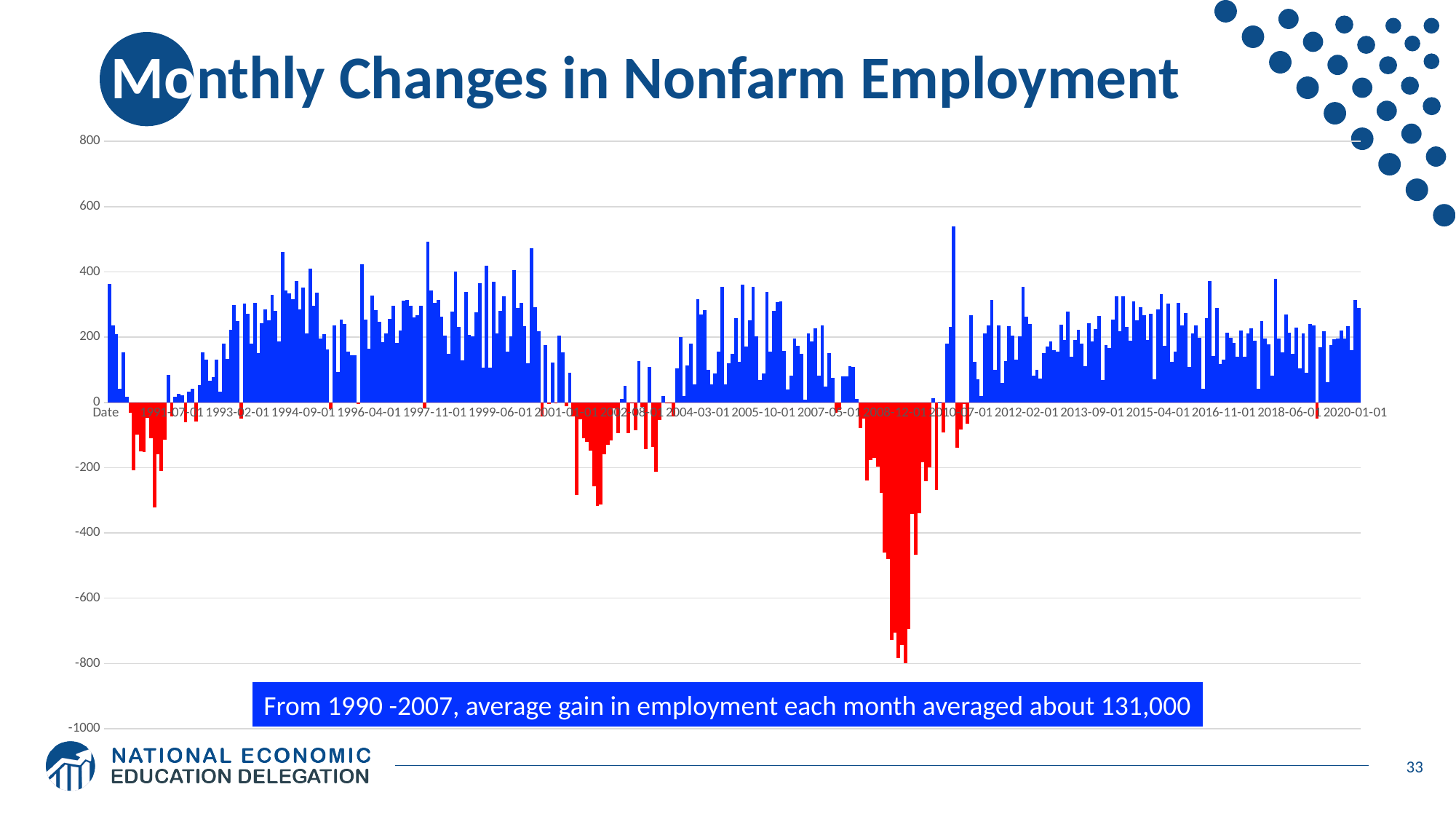
Is the deepest red bar in the 2001-2002 period greater or less than -200? less Is the tallest blue bar in the 1990s (around 1997-1998) greater or less than 400? greater What kind of chart is shown on the slide? bar chart According to the text box on the chart, what was the average monthly employment gain from 1990-2007? about 131,000 What colour are the bars representing negative monthly changes? red Which period shows the larger monthly job loss: the red bars around 2008-12-01 or the red bars around 2001-2002? around 2008-12-01 Is the tallest blue bar, which appears shortly after 2010, greater or less than 400? greater